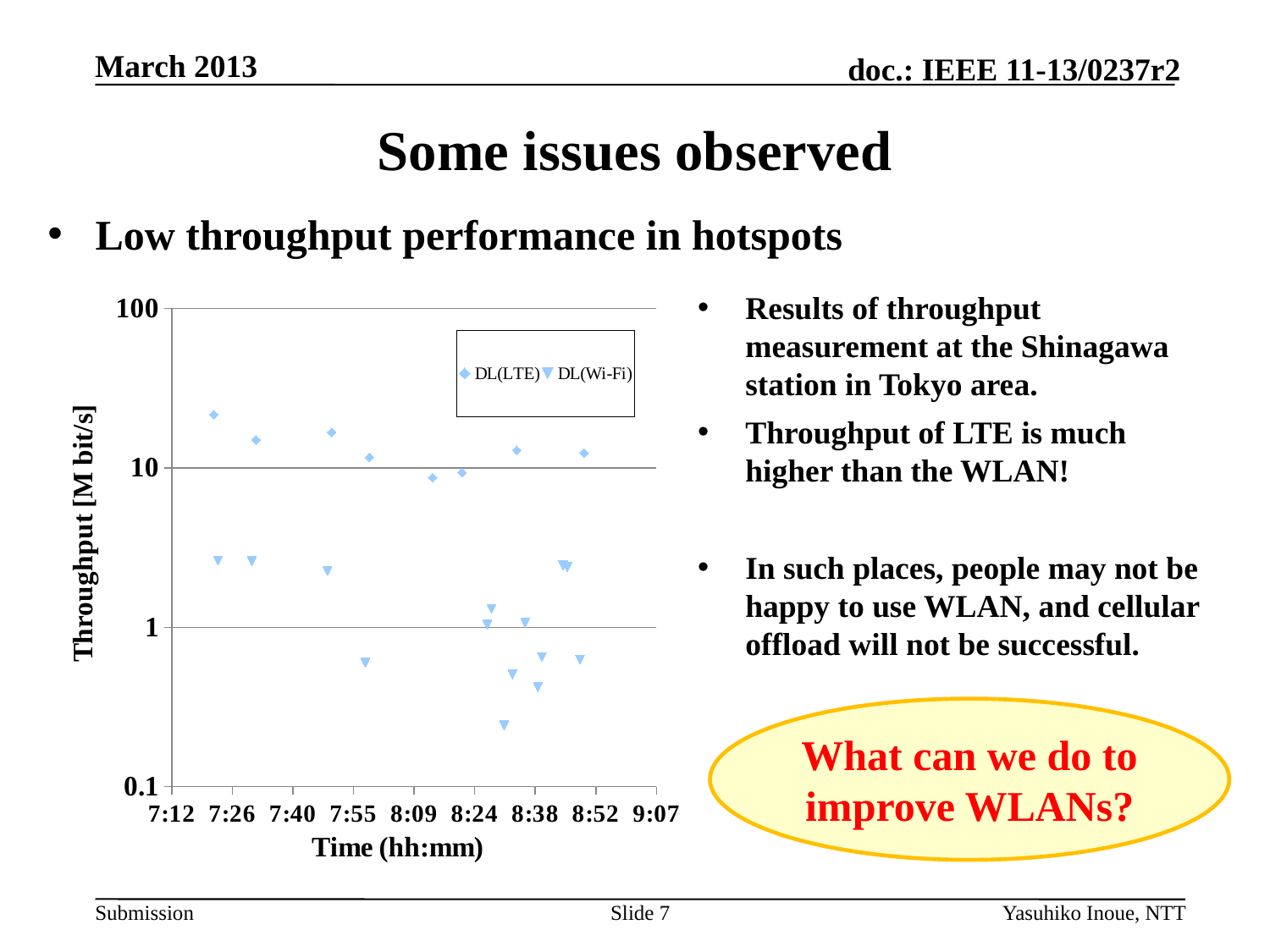
What is the highest value shown on the chart's vertical axis? 100 How many series does the chart legend list? 2 Is the lowest DL(Wi-Fi) point greater or less than 1 M bit/s? less What is the lowest value shown on the chart's vertical axis? 0.1 How many DL(LTE) data points are plotted on the chart? 8 Is the highest DL(Wi-Fi) point greater or less than 10 M bit/s? less What are the two series named in the chart legend? DL(LTE) and DL(Wi-Fi) Are all DL(LTE) points greater or less than 1 M bit/s? greater What kind of chart is shown on the slide? Scatter chart Which series shows higher throughput values overall, DL(LTE) or DL(Wi-Fi)? DL(LTE) What is the label of the chart's vertical axis? Throughput [M bit/s]